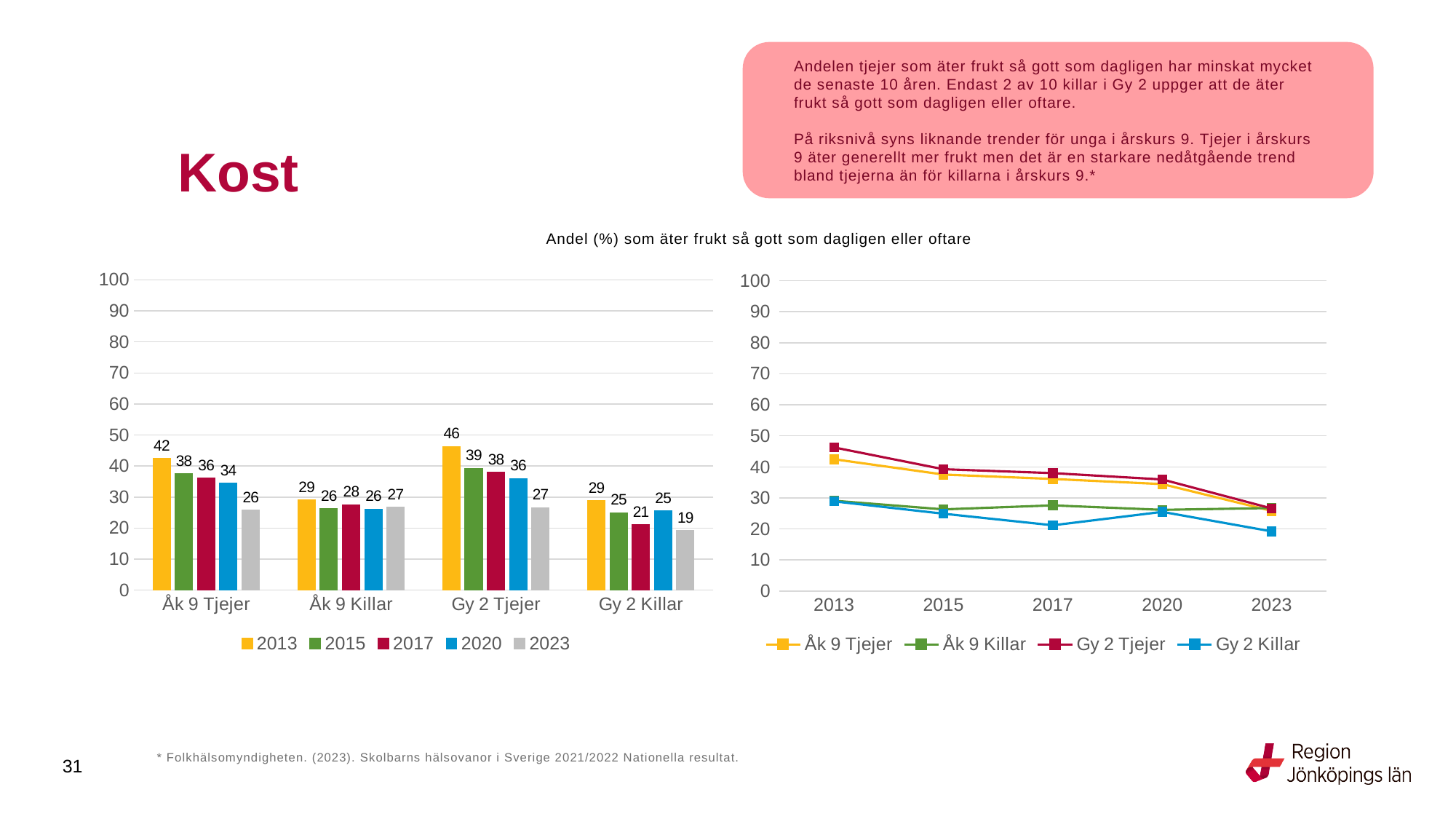
In the bar chart on the left, what is the value for Gy 2 Tjejer in 2013? 46 What kind of chart is the chart on the right? Line chart How many series does the legend of the bar chart on the left list? 5 How many categories are shown on the x axis of the bar chart on the left? 4 In the bar chart on the left, which category has the highest value for 2013? Gy 2 Tjejer In the bar chart on the left, which category has the lowest value for 2023? Gy 2 Killar In the bar chart on the left, which is larger for 2020: Åk 9 Tjejer or Gy 2 Tjejer? Gy 2 Tjejer In the bar chart on the left, what is the value for Åk 9 Killar in 2023? 27 In the bar chart on the left, what is the difference between the 2013 and 2023 values for Åk 9 Tjejer? 16 In the line chart on the right, does the Gy 2 Tjejer series rise or fall from 2013 to 2023? Fall In the bar chart on the left, what is the value for Gy 2 Killar in 2017? 21